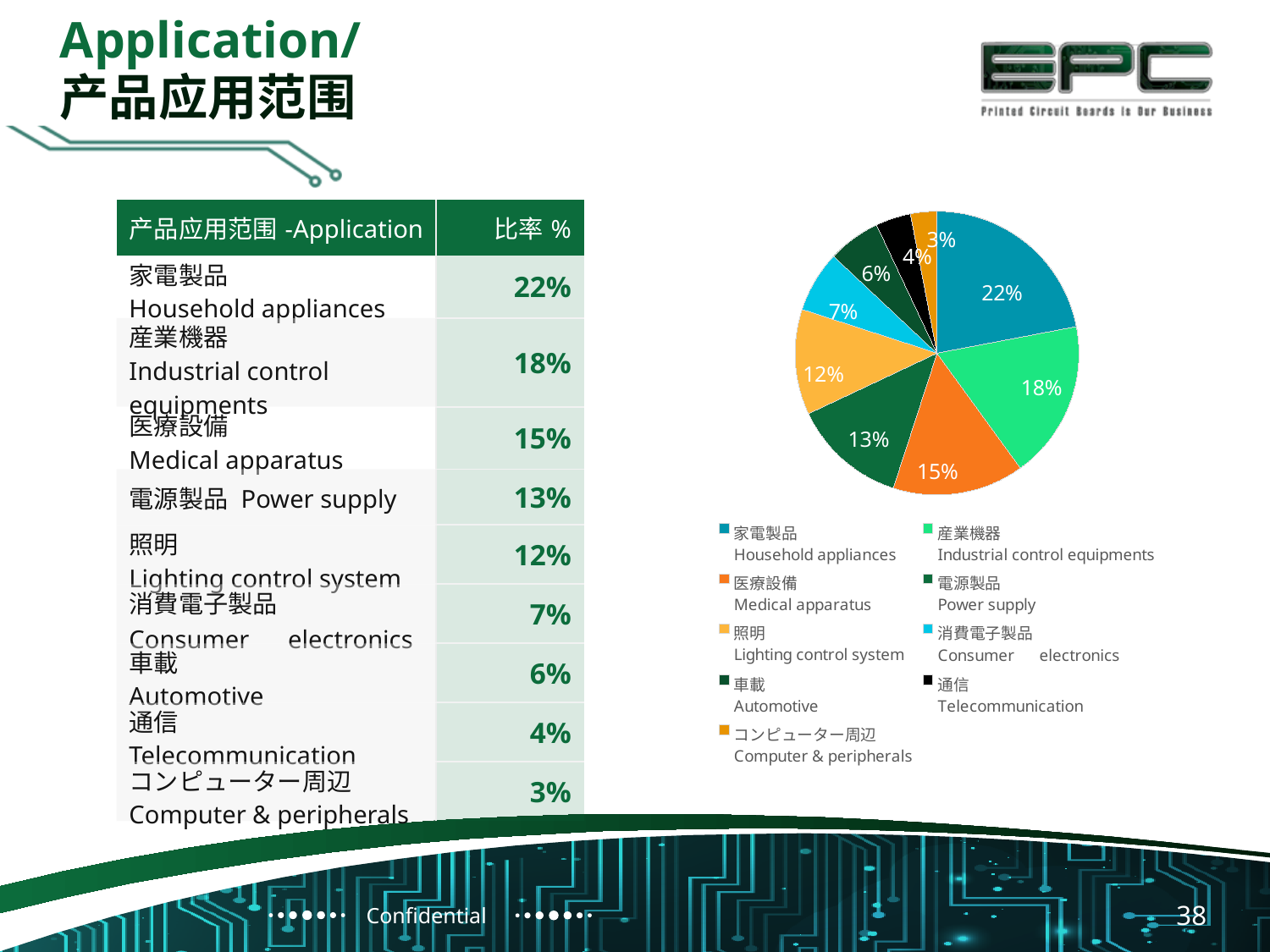
What is the value for Telecommunication in the pie chart? 4% What is the value for Lighting control system in the pie chart? 12% What kind of chart is shown on the slide? pie chart What is the value for Medical apparatus in the pie chart? 15% How many slices does the pie chart have? 9 What is the combined share of Automotive and Telecommunication in the pie chart? 10% Which category has the smallest slice in the pie chart? Computer & peripherals How many entries does the pie chart legend list? 9 What share of the pie chart does Household appliances have? 22% Which category has the largest slice in the pie chart? Household appliances What is the difference between the Household appliances and Industrial control equipments shares? 4% Which is larger in the pie chart, Power supply or Consumer electronics? Power supply